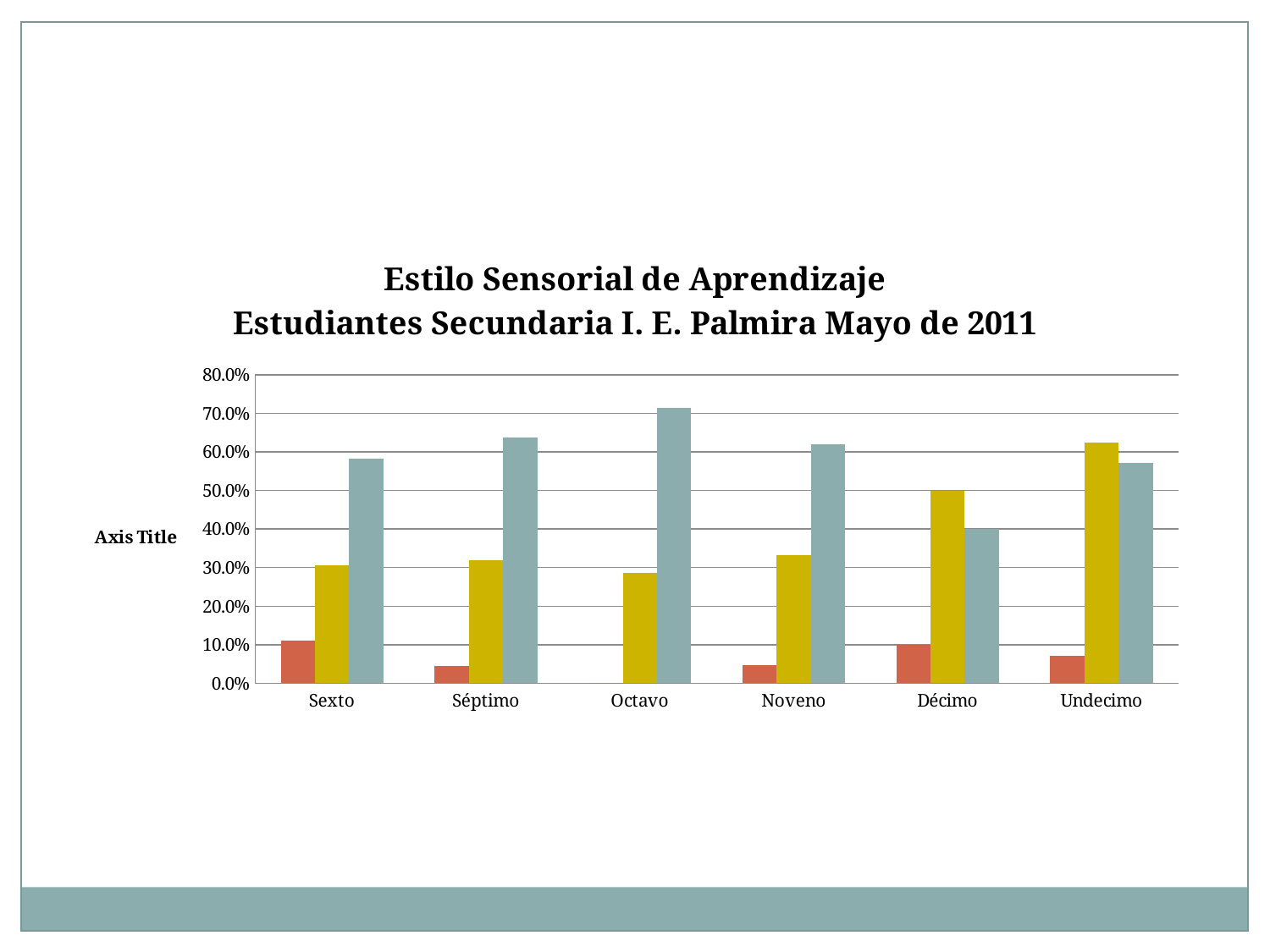
Which category has the tallest yellow bar? Undecimo What is the title of the chart? Estilo Sensorial de Aprendizaje Estudiantes Secundaria I. E. Palmira Mayo de 2011 For Undecimo, which is larger, the yellow bar or the grey bar? the yellow bar Is the grey bar for Octavo greater or less than 60.0%? greater For Sexto, which is larger, the grey bar or the yellow bar? the grey bar What is the label shown on the vertical axis? Axis Title Is the yellow bar for Noveno greater or less than 30.0%? greater Is the grey bar for Séptimo greater or less than 60.0%? greater Which category has the tallest grey bar? Octavo Which category has the shortest grey bar? Décimo What kind of chart is shown on the slide? bar chart How many grade categories are shown on the x axis? 6